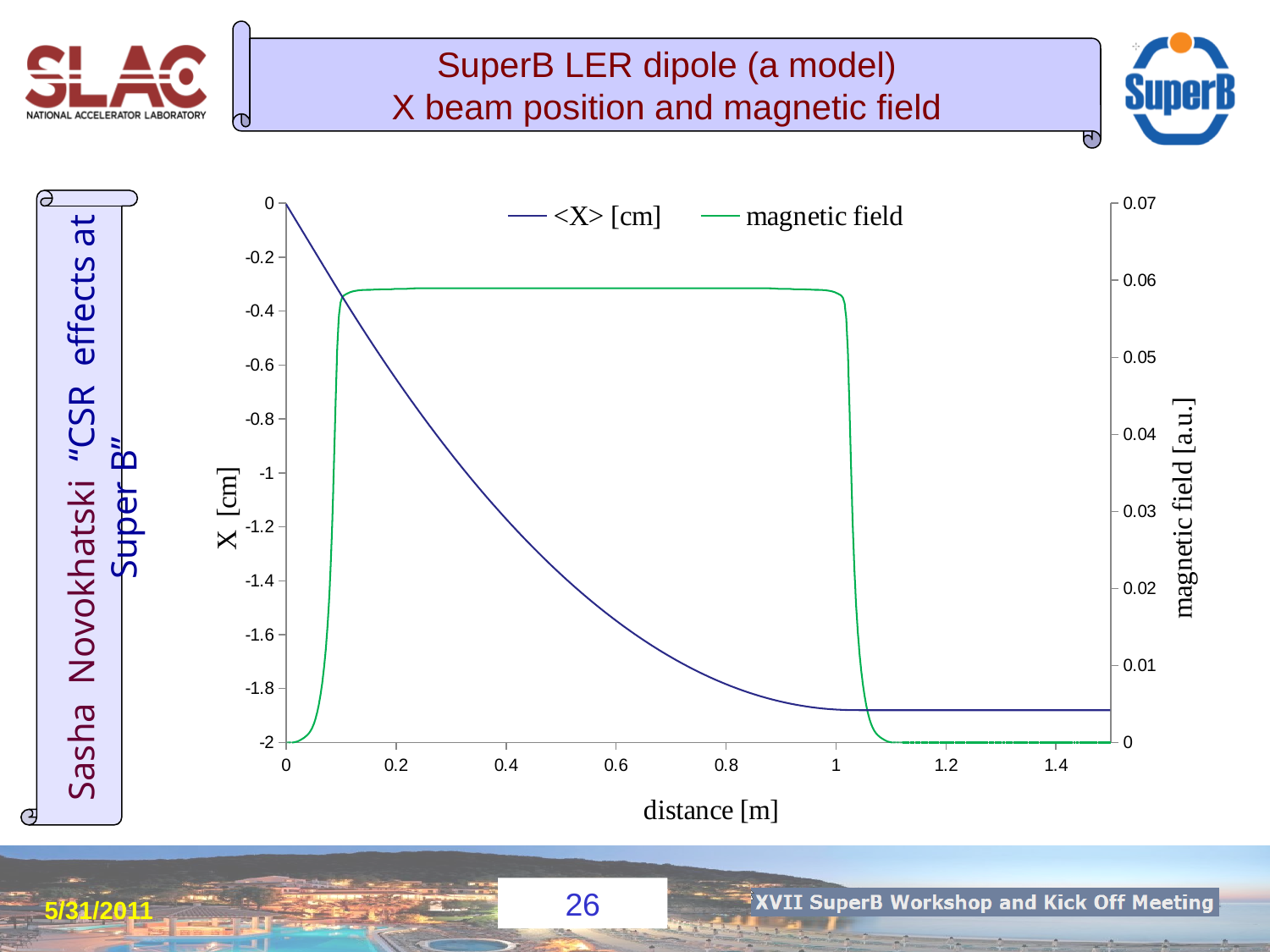
Is the value of <X> [cm] at distance 1.4 greater or less than -1.8? less Is the magnetic field at distance 1.2 greater or less than 0.01? less Does the <X> [cm] series rise or fall as distance increases from 0 to 1? fall Is the value of <X> [cm] at distance 0.2 greater or less than -0.4? less Which is larger, the magnetic field at distance 0.5 or at distance 1.3? distance 0.5 How many series does the chart legend list? 2 What is the label of the x axis of the chart? distance [m] What kind of chart is shown on the slide? line chart Between distance 0.2 and 0.9, does the magnetic field rise, fall, or stay roughly flat? stay roughly flat What is the label of the right-hand y axis of the chart? magnetic field [a.u.]